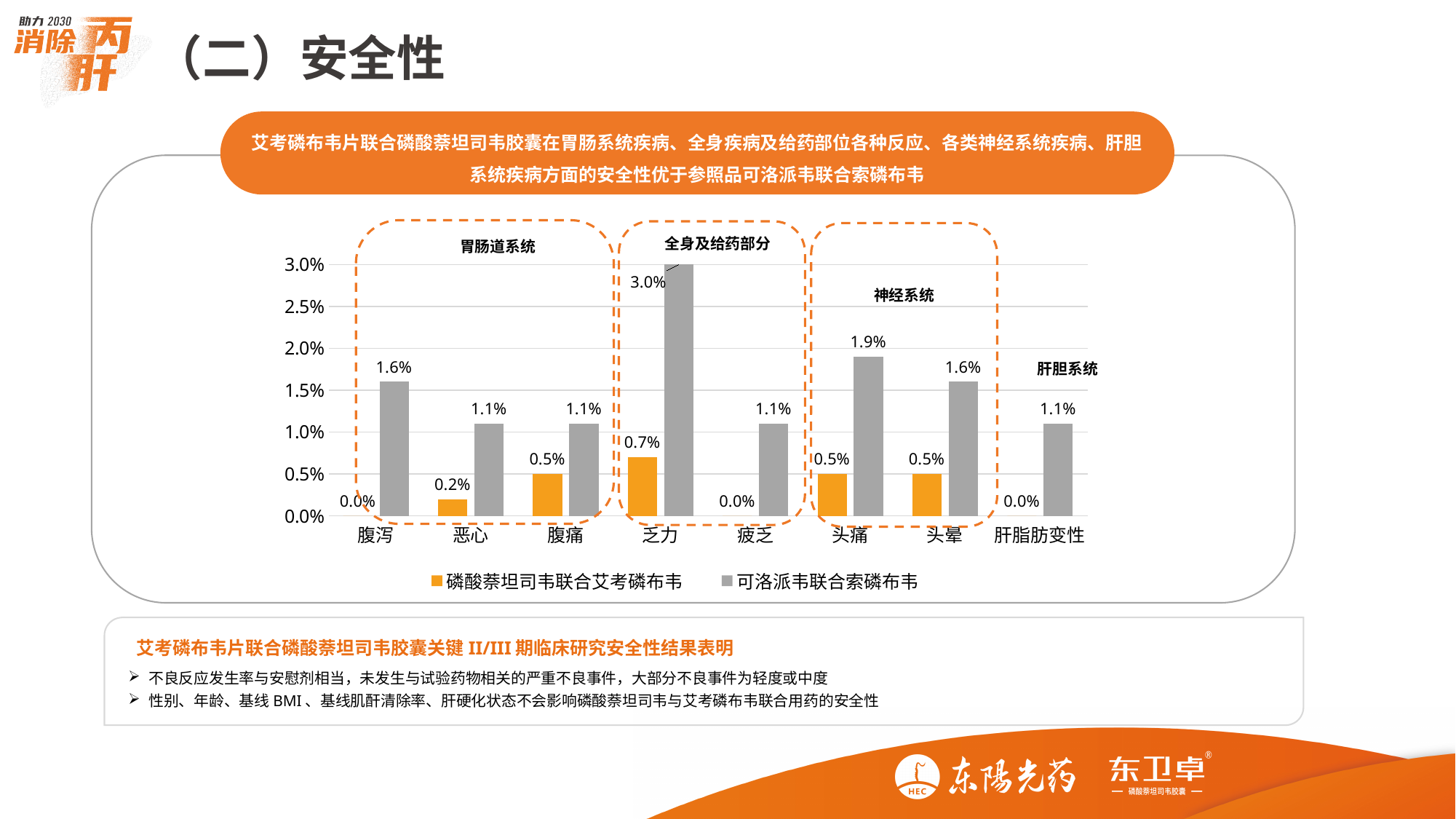
In the 头晕 category, which series has the larger value? 可洛派韦联合索磷布韦 What is the value for 可洛派韦联合索磷布韦 in the 乏力 category? 3.0% What is the difference between the two series in the 乏力 category? 2.3% What is the difference between the two series in the 腹泻 category? 1.6% Which series is shown in orange in the chart? 磷酸萘坦司韦联合艾考磷布韦 Which category has the highest value for 可洛派韦联合索磷布韦? 乏力 Which category has the highest value for 磷酸萘坦司韦联合艾考磷布韦? 乏力 What type of chart is shown on the slide? bar chart What is the value for 可洛派韦联合索磷布韦 in the 头痛 category? 1.9% How many categories are shown on the x axis of the chart? 8 How many series does the chart legend list? 2 What is the value for 磷酸萘坦司韦联合艾考磷布韦 in the 恶心 category? 0.2%